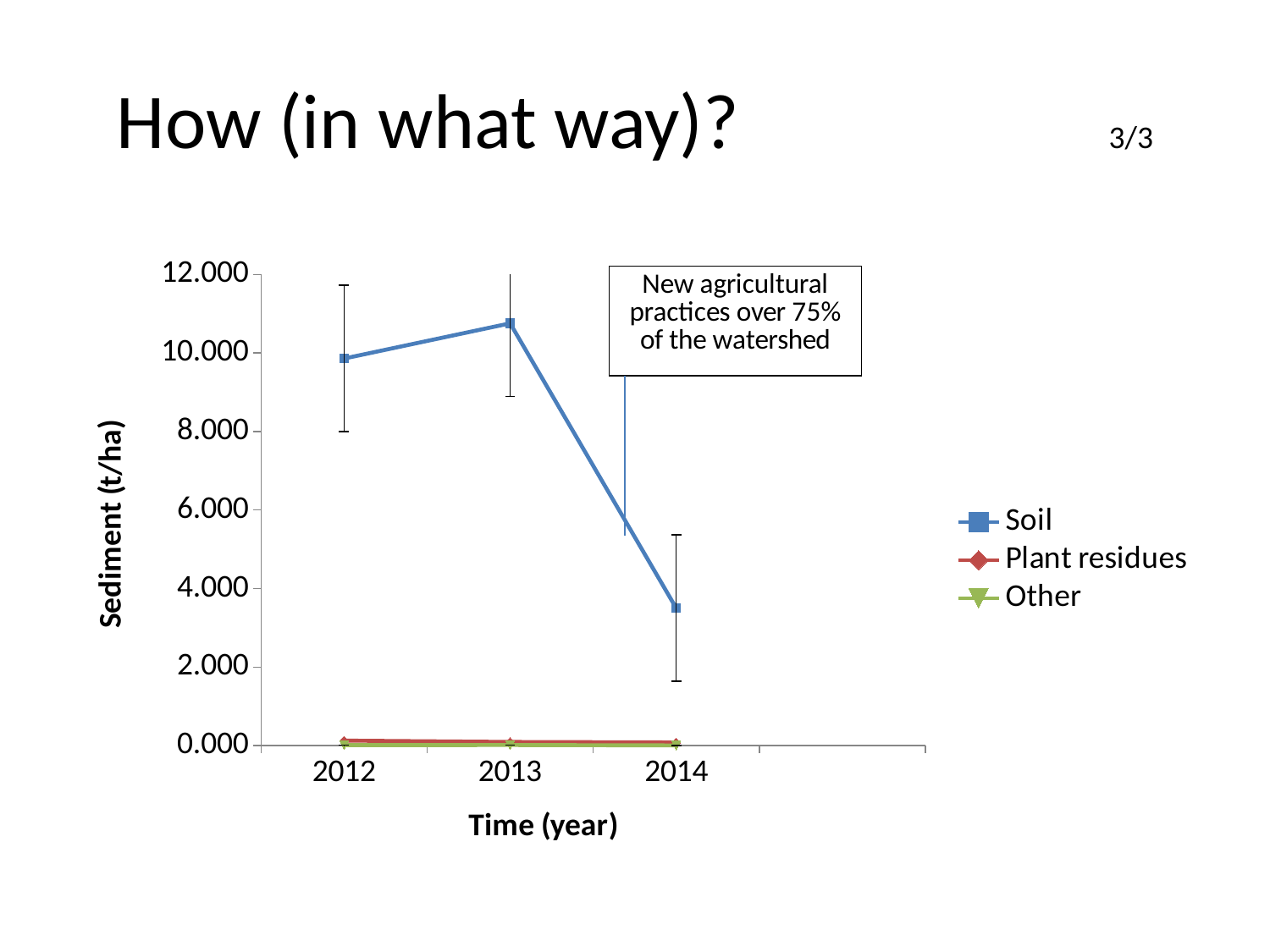
Is the Soil value for 2014 greater or less than 4.000? less What kind of chart is shown on the slide? line chart Is the Soil value for 2012 greater or less than 8.000? greater Which is larger, the Soil value for 2012 or for 2014? 2012 How many series does the legend list? 3 In which year is the Soil value lowest? 2014 In which year is the Soil value highest? 2013 Which series is plotted with the blue line? Soil Does the Soil series rise or fall from 2013 to 2014? fall Is the Soil value for 2013 greater or less than 10.000? greater How many years are plotted on the x axis? 3 What is the title of the y axis? Sediment (t/ha)